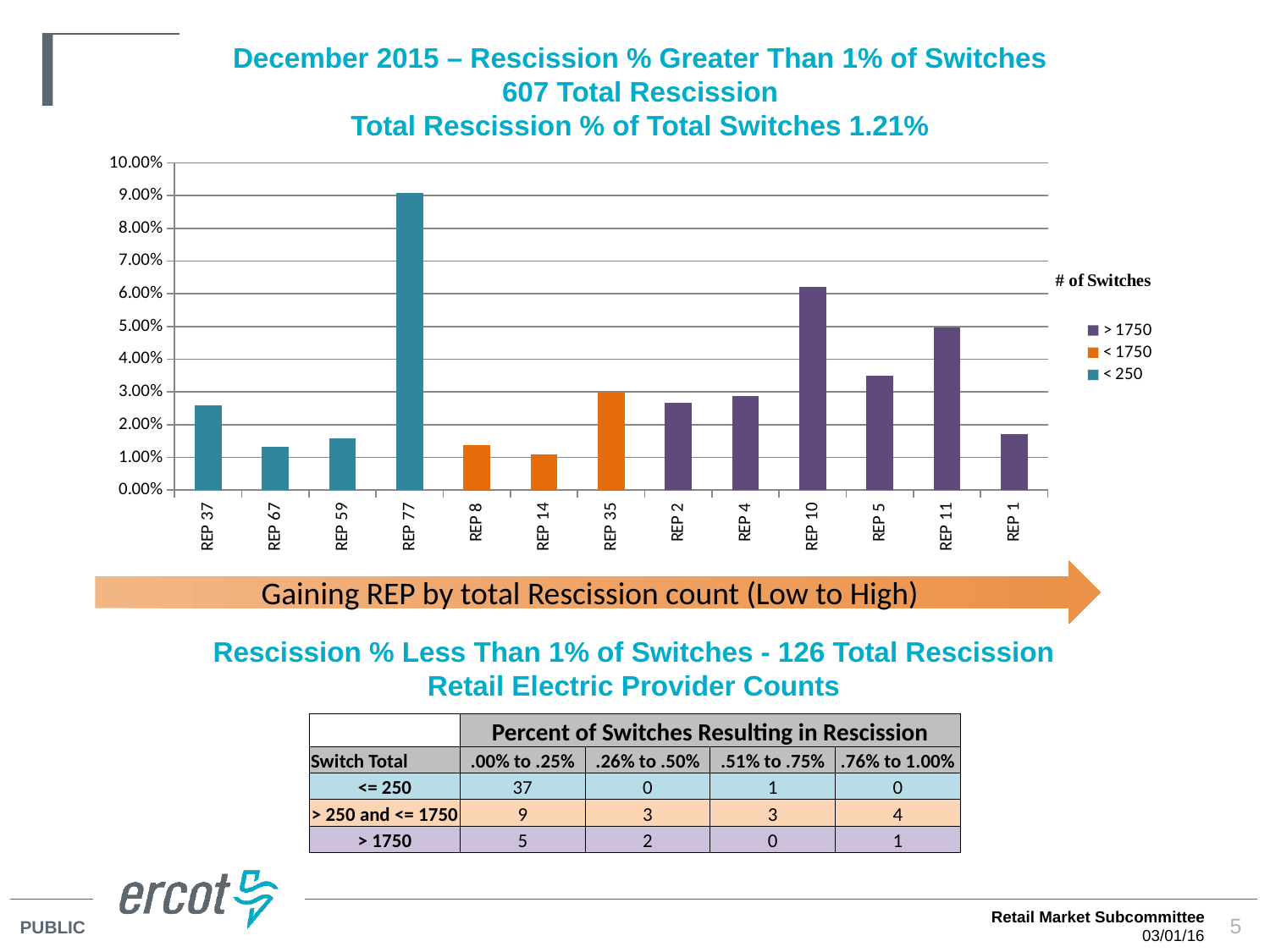
How many series does the chart's legend list? 3 What kind of chart is shown on the slide? bar chart Is the value for REP 1 greater or less than 2.00%? less According to the chart title, what is the total rescission count for December 2015? 607 Which has the larger rescission percentage, REP 10 or REP 11? REP 10 Is the value for REP 77 greater or less than 8.00%? greater Is the value for REP 5 greater or less than 3.00%? greater Which REP has the highest rescission percentage in the chart? REP 77 What is the title shown above the legend of the chart? # of Switches How many REP categories are plotted on the x axis of the chart? 13 Which has the larger rescission percentage, REP 37 or REP 67? REP 37